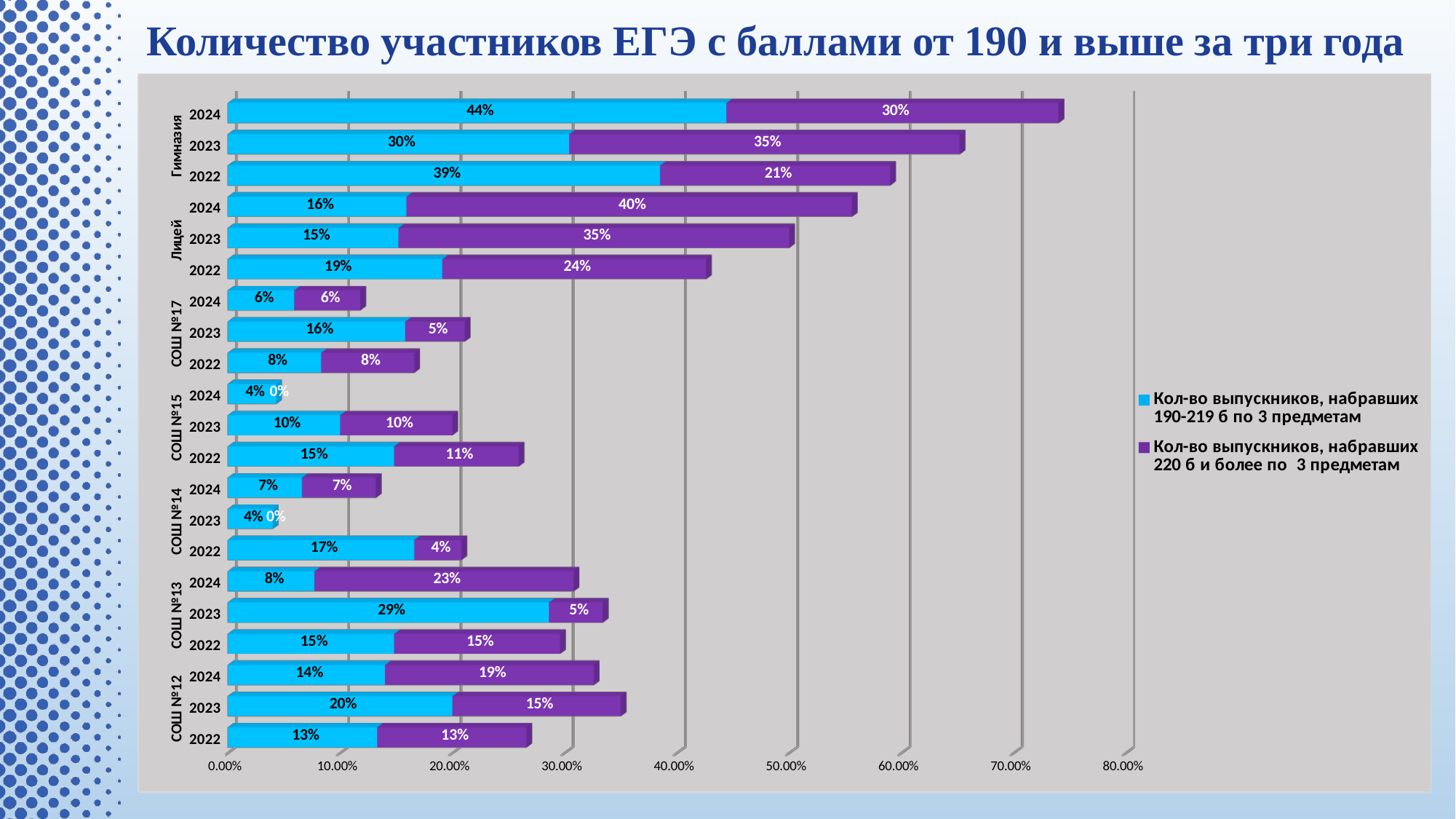
What is the value for Лицей in 2024 for the series 'Кол-во выпускников, набравших 220 б и более по 3 предметам'? 40% What kind of chart is shown on the slide? Stacked bar chart Which school and year has the highest value for the series 'Кол-во выпускников, набравших 220 б и более по 3 предметам'? Лицей, 2024 What is the value for СОШ №13 in 2023 for the series 'Кол-во выпускников, набравших 190-219 б по 3 предметам'? 29% Is the total stacked bar for Гимназия in 2024 greater or less than 70.00%? greater What is the value for Гимназия in 2024 for the series 'Кол-во выпускников, набравших 190-219 б по 3 предметам'? 44% What is the difference between the 2024 and 2023 values for Гимназия in the series 'Кол-во выпускников, набравших 190-219 б по 3 предметам'? 14% Which is larger for СОШ №12 in 2024: the 190-219 б series or the 220 б и более series? 220 б и более What is the total of the stacked bar for Лицей in 2023? 50% How many series does the legend list? 2 How many stacked bars are plotted on the chart? 21 Which school and year has the highest value for the series 'Кол-во выпускников, набравших 190-219 б по 3 предметам'? Гимназия, 2024